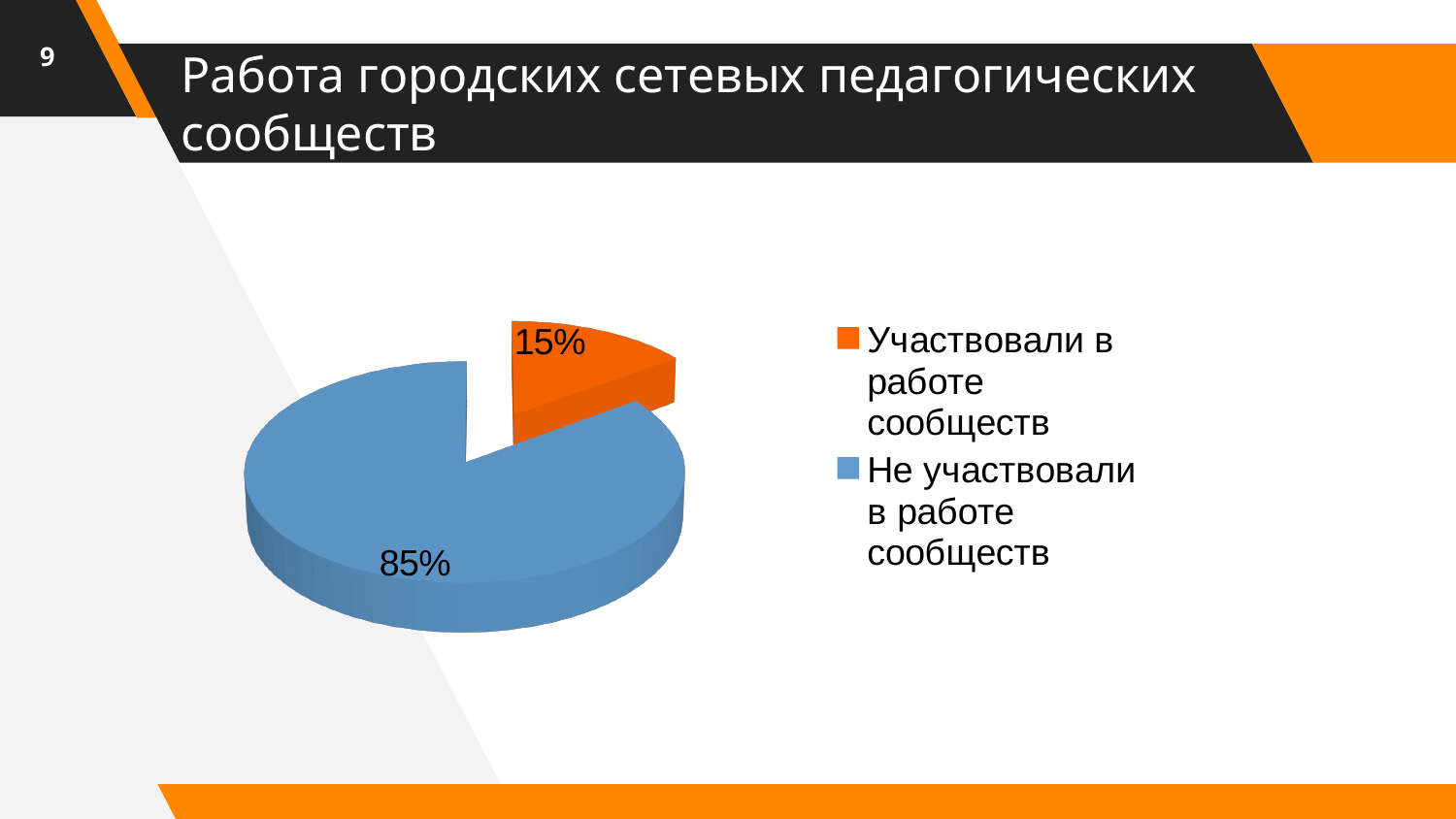
Which slice is larger: "Участвовали в работе сообществ" or "Не участвовали в работе сообществ"? Не участвовали в работе сообществ How many entries does the legend list? 2 Which category has the largest slice of the pie? Не участвовали в работе сообществ How many slices does the pie chart have? 2 What share of the pie is labelled "Не участвовали в работе сообществ"? 85% What share of the pie is labelled "Участвовали в работе сообществ"? 15% What colour is the slice for "Участвовали в работе сообществ"? orange Which category has the smallest slice of the pie? Участвовали в работе сообществ What is the difference in percentage points between the "Не участвовали в работе сообществ" slice and the "Участвовали в работе сообществ" slice? 70 What kind of chart is shown on the slide? pie chart What is the title of the slide containing the pie chart? Работа городских сетевых педагогических сообществ